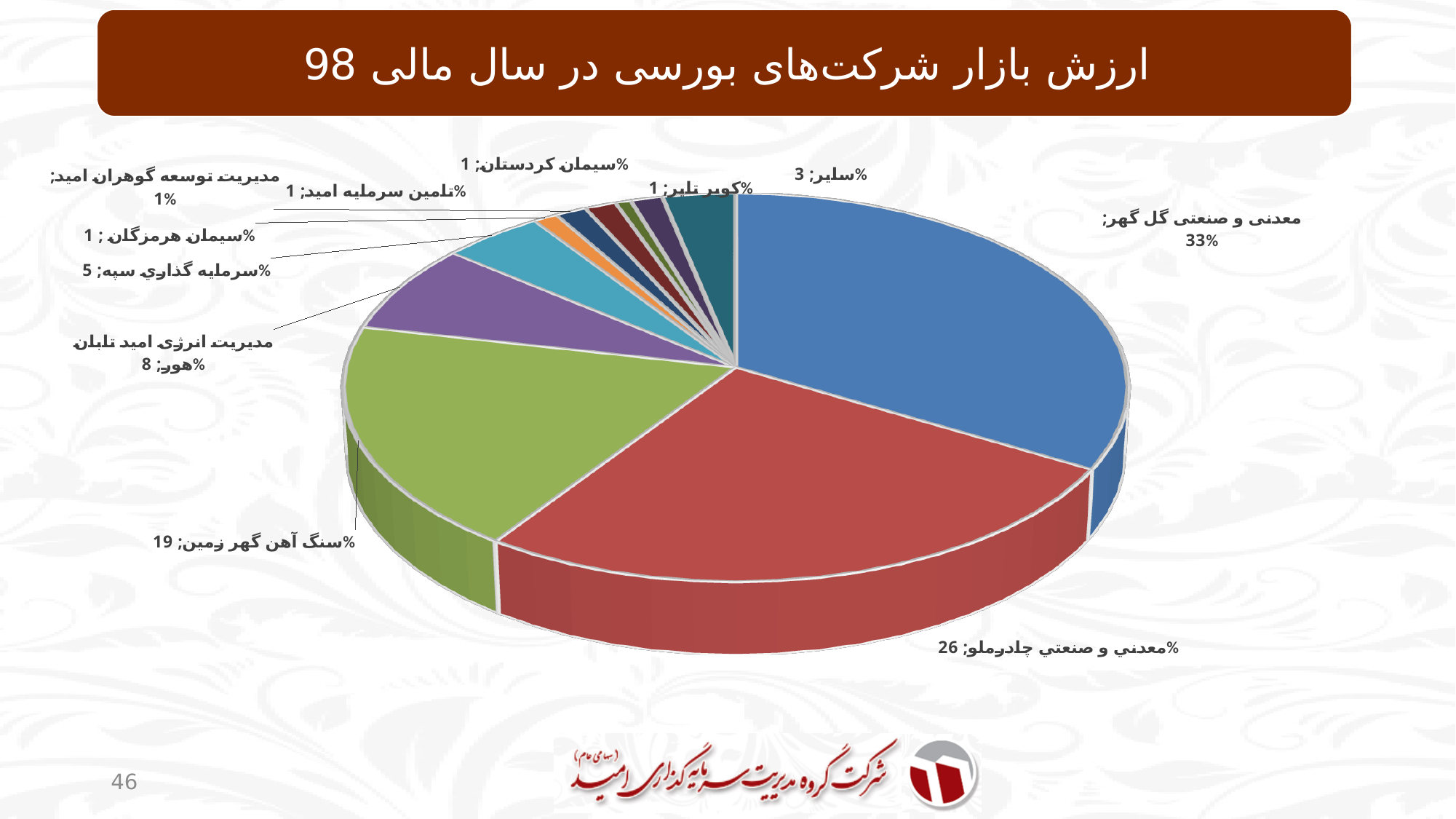
What is the value shown for سنگ آهن گهر زمین? 19% Which is larger, the share of سنگ آهن گهر زمین or the share of مدیریت انرژی امید تابان هور? سنگ آهن گهر زمین How many slices does the pie chart have? 11 What is the value shown for سایر? 3% Which category has the largest slice of the pie? معدنی و صنعتی گل گهر What kind of chart is shown on the slide? pie chart What is the value shown for سرمایه گذاري سپه? 5% What is the title of the slide? ارزش بازار شرکت‌های بورسی در سال مالی 98 What share of the pie does معدني و صنعتي چادرملو hold? 26% What is the difference between the shares of معدنی و صنعتی گل گهر and معدني و صنعتي چادرملو? 7% What is the value shown for مدیریت انرژی امید تابان هور? 8% What share of the pie does معدنی و صنعتی گل گهر hold? 33%